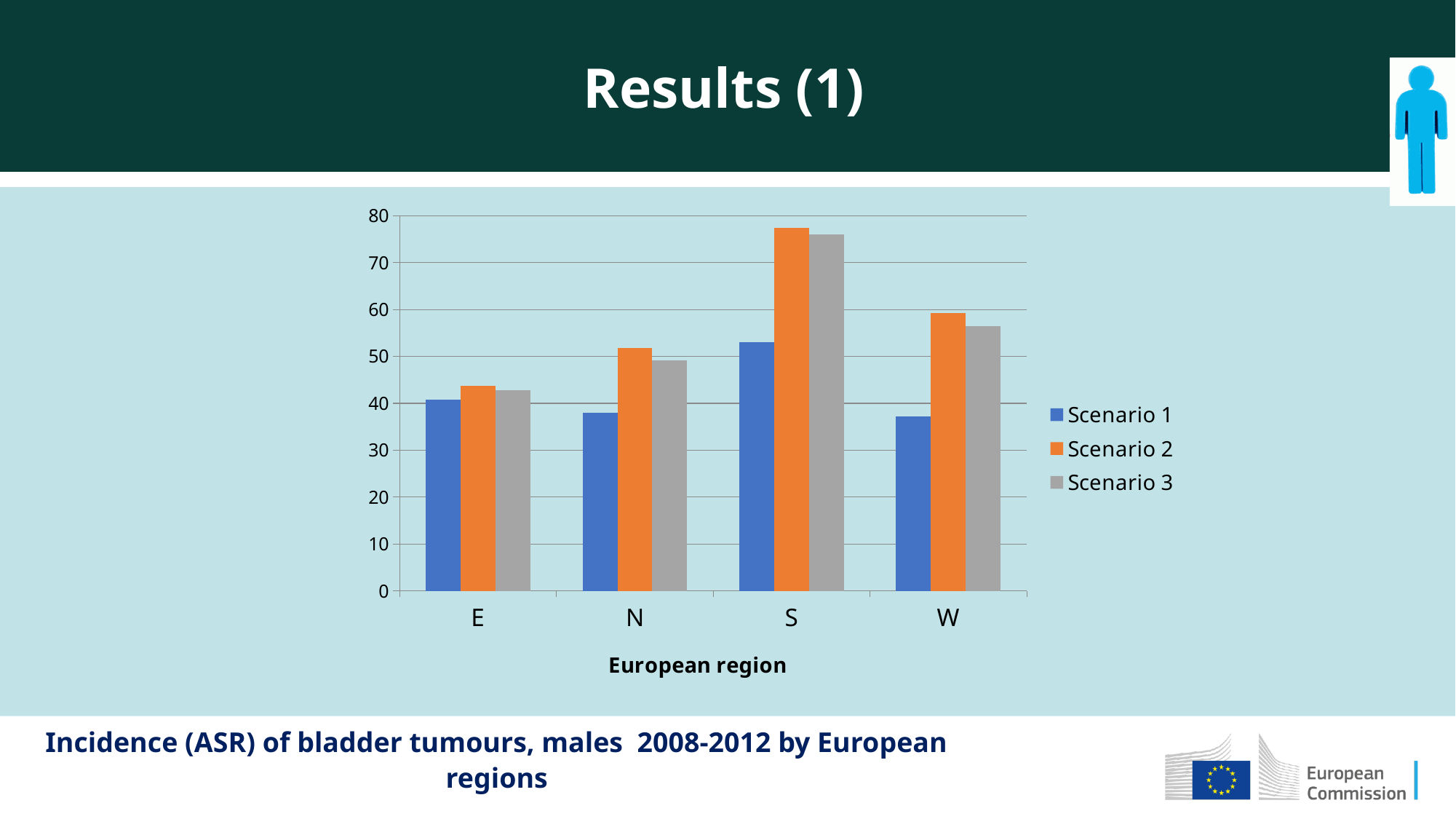
How many European regions are shown on the x axis of the chart? 4 Which region has the lowest Scenario 2 value? E Is the Scenario 2 value for W greater or less than 50? greater What kind of chart is shown on the slide? bar chart What is the title of the chart's x axis? European region For region S, which is larger: the Scenario 1 value or the Scenario 2 value? Scenario 2 How many series does the chart's legend list? 3 Which region has the highest Scenario 2 value? S Which region has the highest Scenario 3 value? S For region W, which is larger: the Scenario 2 value or the Scenario 3 value? Scenario 2 Is the Scenario 2 value for S greater or less than 70? greater Is the Scenario 1 value for W greater or less than 40? less